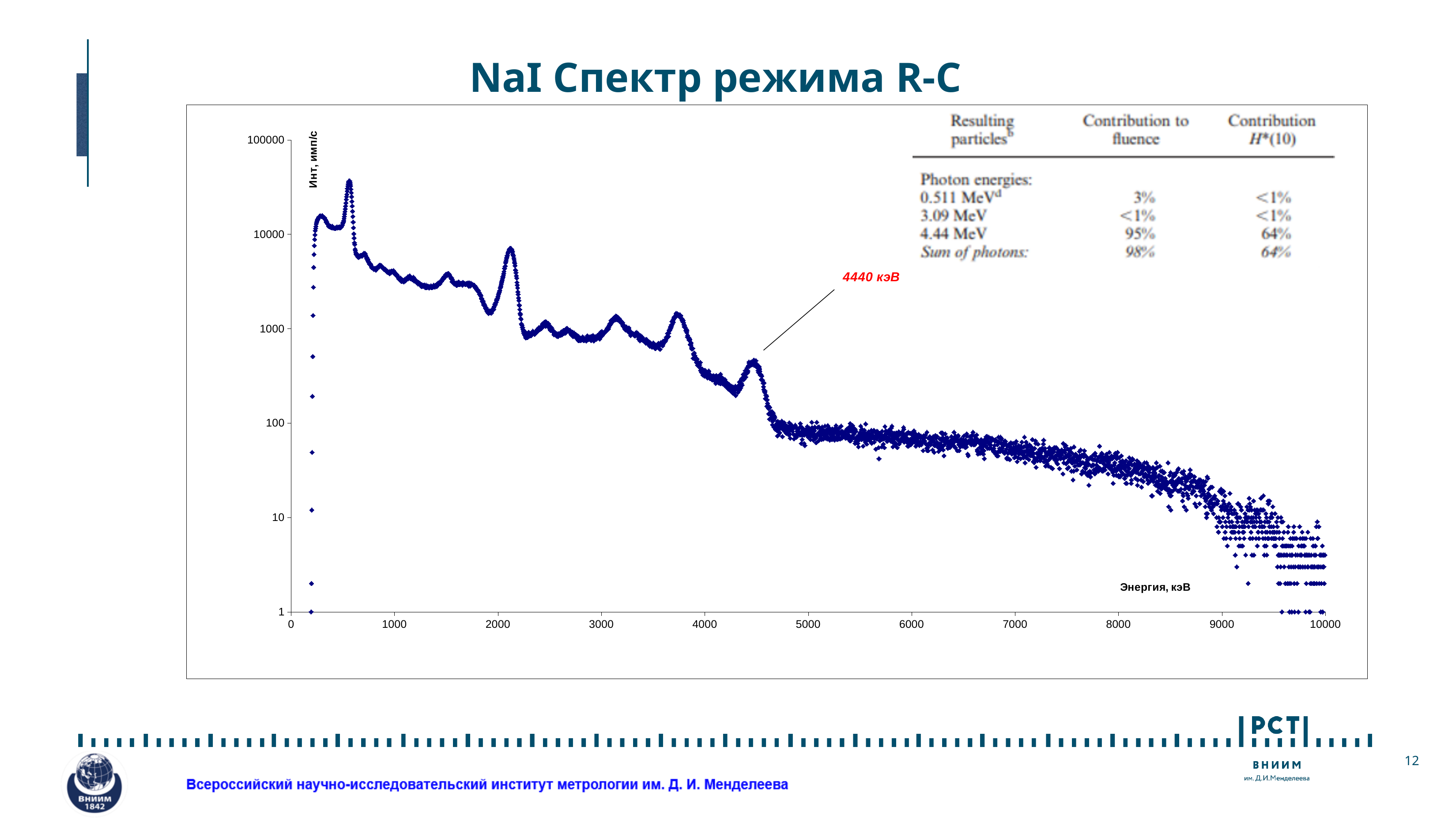
Overall, do the plotted intensity values rise or fall as energy increases along the x axis? fall Is the intensity at the peak annotated 4440 кэВ greater or less than 1000? less Is the intensity at the highest peak of the spectrum greater or less than 10000? greater What is the label of the vertical axis of the chart? Инт, имп/с What is the title of the slide containing the chart? NaI Спектр режима R-C Is the intensity at 6000 on the x axis greater or less than 100? less What is the highest tick value shown on the vertical axis? 100000 What is the label of the horizontal axis of the chart? Энергия, кэВ What energy value is written in the red annotation pointing to the peak near 4500 on the x axis? 4440 кэВ What is the highest tick value shown on the horizontal axis? 10000 What kind of chart is shown on the slide? scatter chart